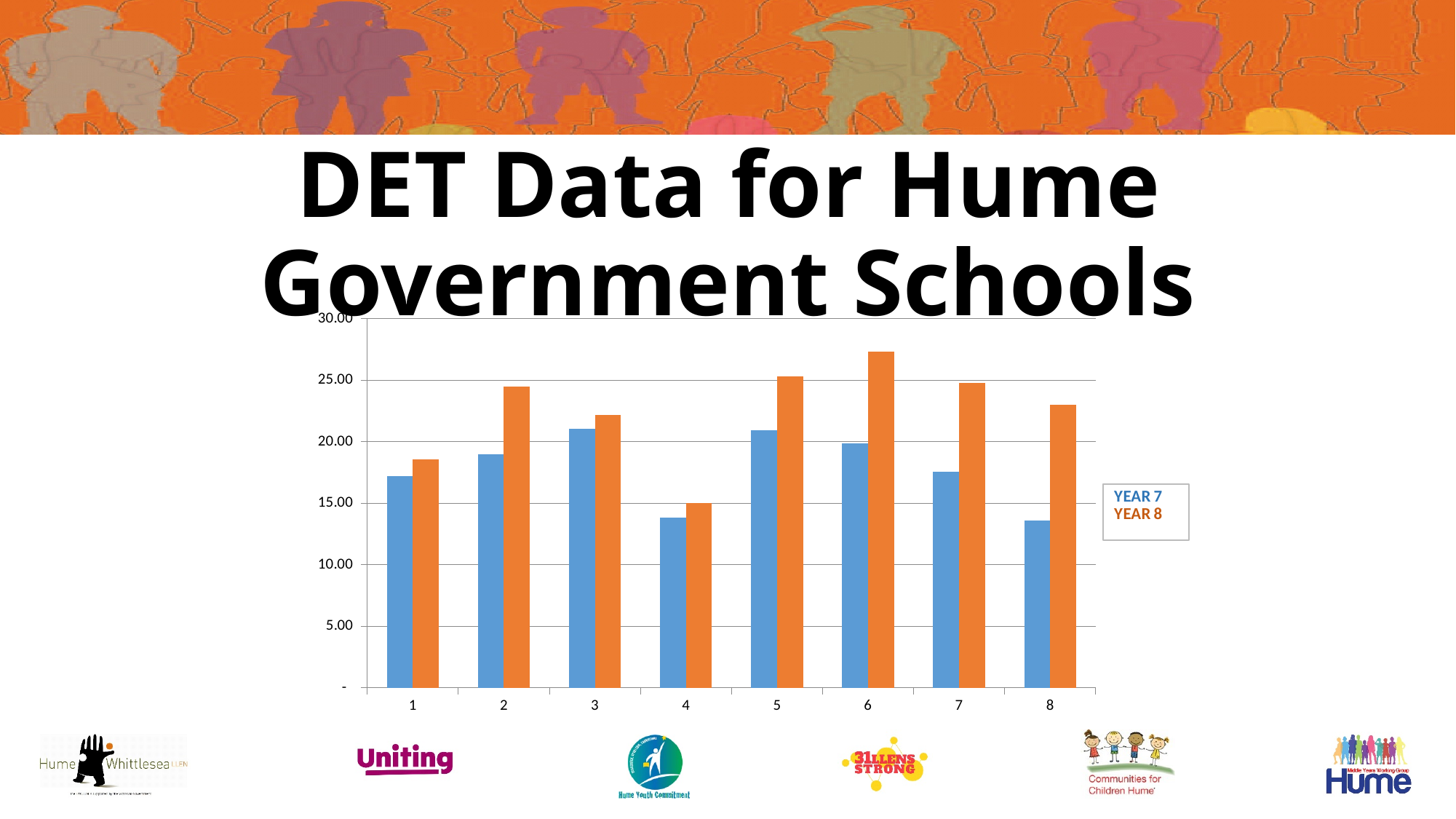
Is the YEAR 8 value for category 6 greater or less than 25.00? greater What kind of chart is shown on the slide? Bar chart Which category has the lowest YEAR 8 value? 4 Which is larger, the YEAR 7 value for category 3 or the YEAR 7 value for category 4? Category 3 Is the YEAR 8 value for category 8 greater or less than 20.00? greater How many categories are shown along the x axis of the chart? 8 For category 8, which series has the larger value, YEAR 7 or YEAR 8? YEAR 8 Which colour represents the YEAR 8 series in the chart? Orange Which category has the highest YEAR 8 value? 6 Is the YEAR 7 value for category 2 greater or less than 20.00? less How many series does the chart's legend list? 2